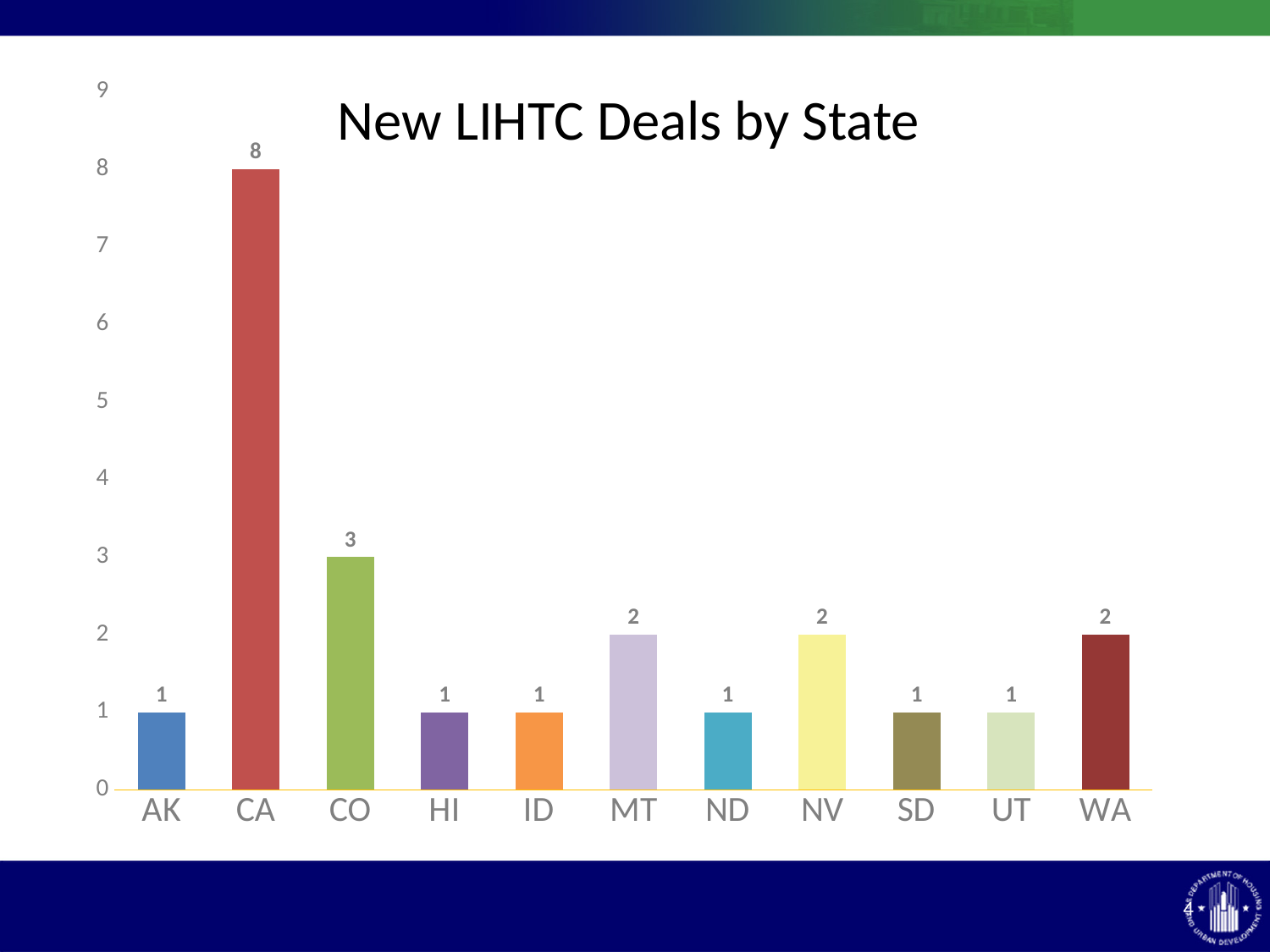
How many states are shown on the x axis? 11 What is the value for CO? 3 Is the value for CA greater or less than 5? greater What is the value for MT? 2 What is the value for CA? 8 What is the difference between the values for NV and ND? 1 What is the difference between the values for CA and CO? 5 Which state has the highest number of new LIHTC deals? CA What is the value for SD? 1 What kind of chart is shown on the slide? bar chart Which is larger, the value for WA or the value for UT? WA What is the title of the chart? New LIHTC Deals by State